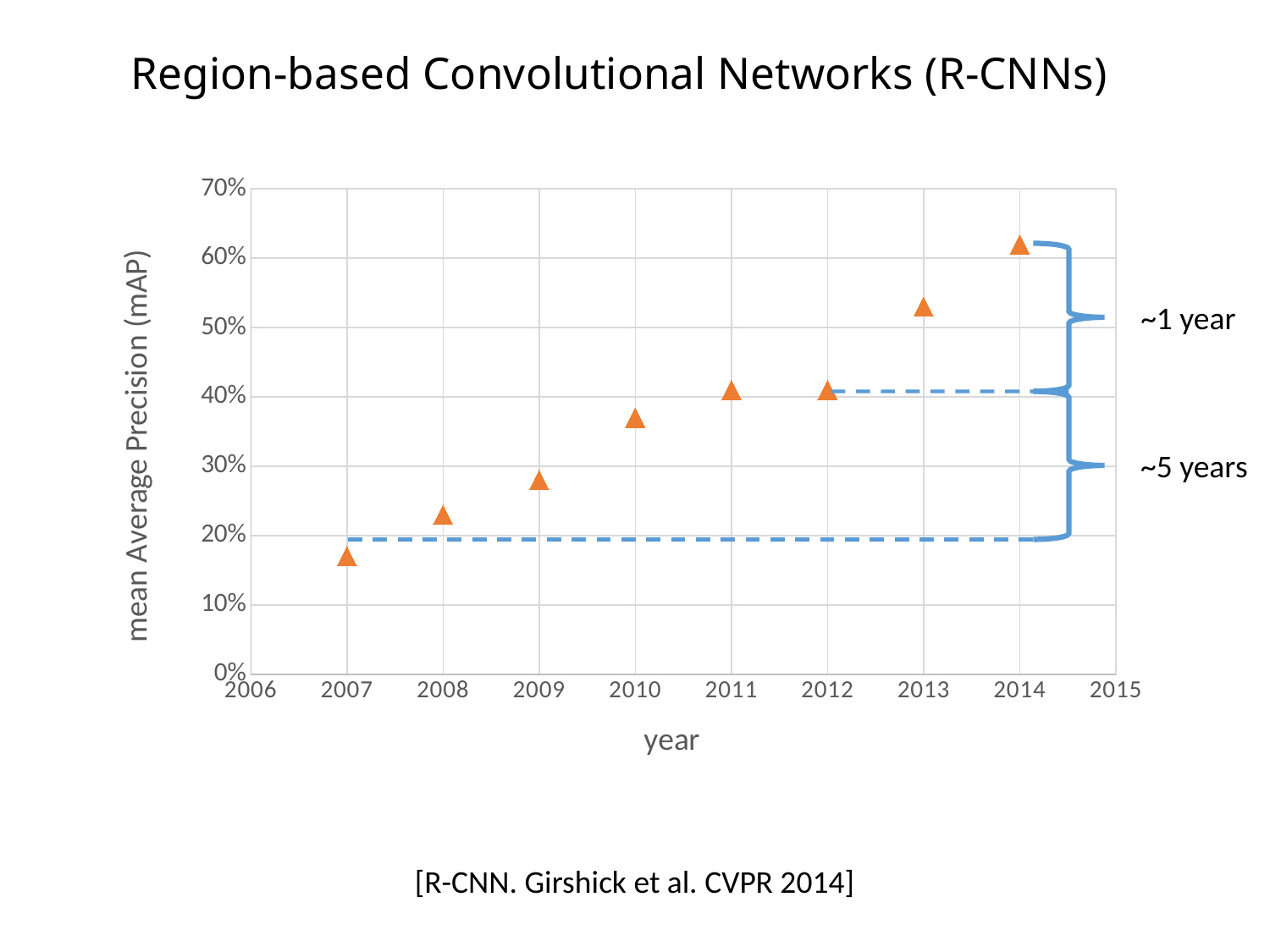
What kind of chart is shown on the slide? scatter chart Is the value for 2010 greater or less than 30%? greater Which year has the highest mean Average Precision? 2014 What is the label of the vertical axis? mean Average Precision (mAP) Do the mAP values generally rise or fall from 2007 to 2014? rise Is the value for 2013 greater or less than 50%? greater Is the value for 2014 greater or less than 60%? greater Which year has a higher mAP, 2010 or 2013? 2013 Which year has the lowest mean Average Precision? 2007 How many data points are plotted on the chart? 8